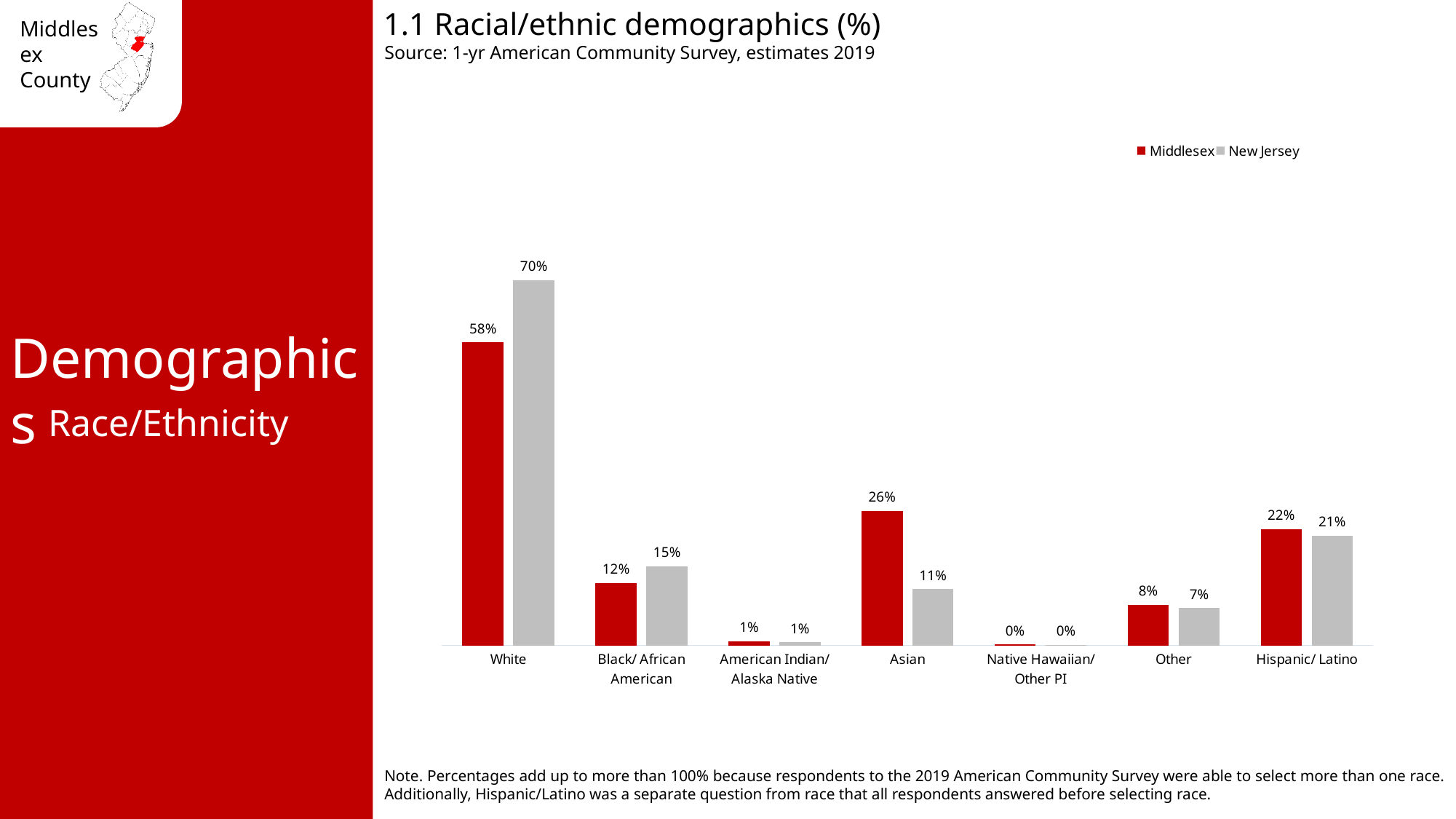
What is the Middlesex value for White? 58% What is the Middlesex value for Hispanic/ Latino? 22% Which category has the lowest Middlesex value? Native Hawaiian/ Other PI What is the difference between the New Jersey and Middlesex values for White? 12% Which series is shown in red? Middlesex What is the difference between the Middlesex and New Jersey values for Asian? 15% Which category has the highest New Jersey value? White How many series does the legend list? 2 How many categories are shown on the x axis? 7 What is the New Jersey value for Asian? 11% Which is larger for Black/ African American: Middlesex or New Jersey? New Jersey What kind of chart is shown? bar chart